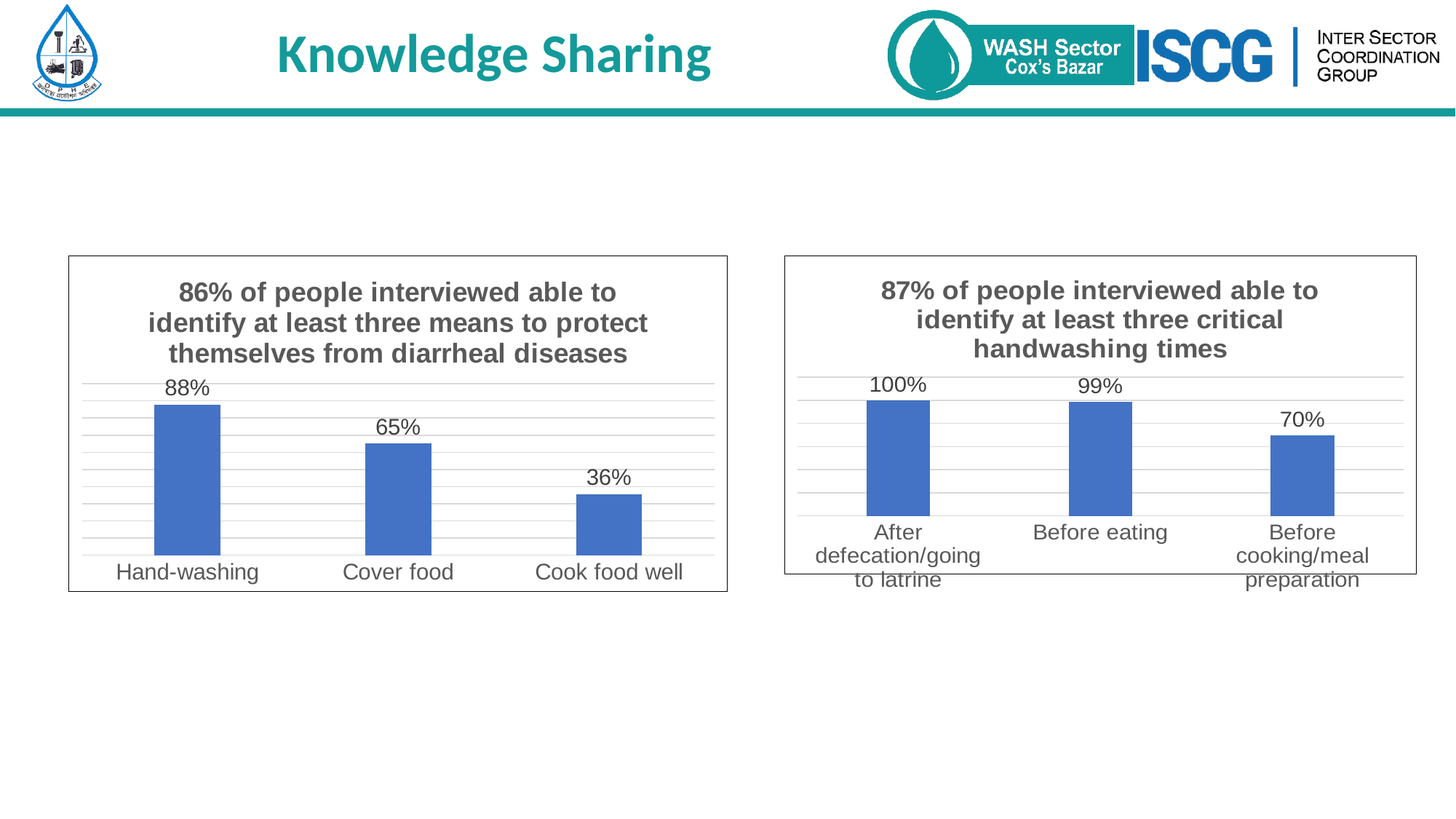
In the right chart on critical handwashing times, what percentage is shown for Before cooking/meal preparation? 70% In the right chart on critical handwashing times, what is the difference between Before eating and Before cooking/meal preparation? 29% In the left chart on diarrheal disease protection, which category has the lowest value? Cook food well In the left chart on diarrheal disease protection, how many categories are plotted? 3 What type of chart is the left chart on diarrheal disease protection? Bar chart In the right chart on critical handwashing times, what percentage is shown for Before eating? 99% In the left chart on diarrheal disease protection, what percentage is shown for Hand-washing? 88% In the right chart on critical handwashing times, which category has the highest value? After defecation/going to latrine In the left chart on diarrheal disease protection, do the values rise or fall from left to right? Fall In the left chart on diarrheal disease protection, what percentage is shown for Cook food well? 36% In the left chart on diarrheal disease protection, what is the difference between Hand-washing and Cover food? 23% In the right chart on critical handwashing times, which is larger: After defecation/going to latrine or Before cooking/meal preparation? After defecation/going to latrine